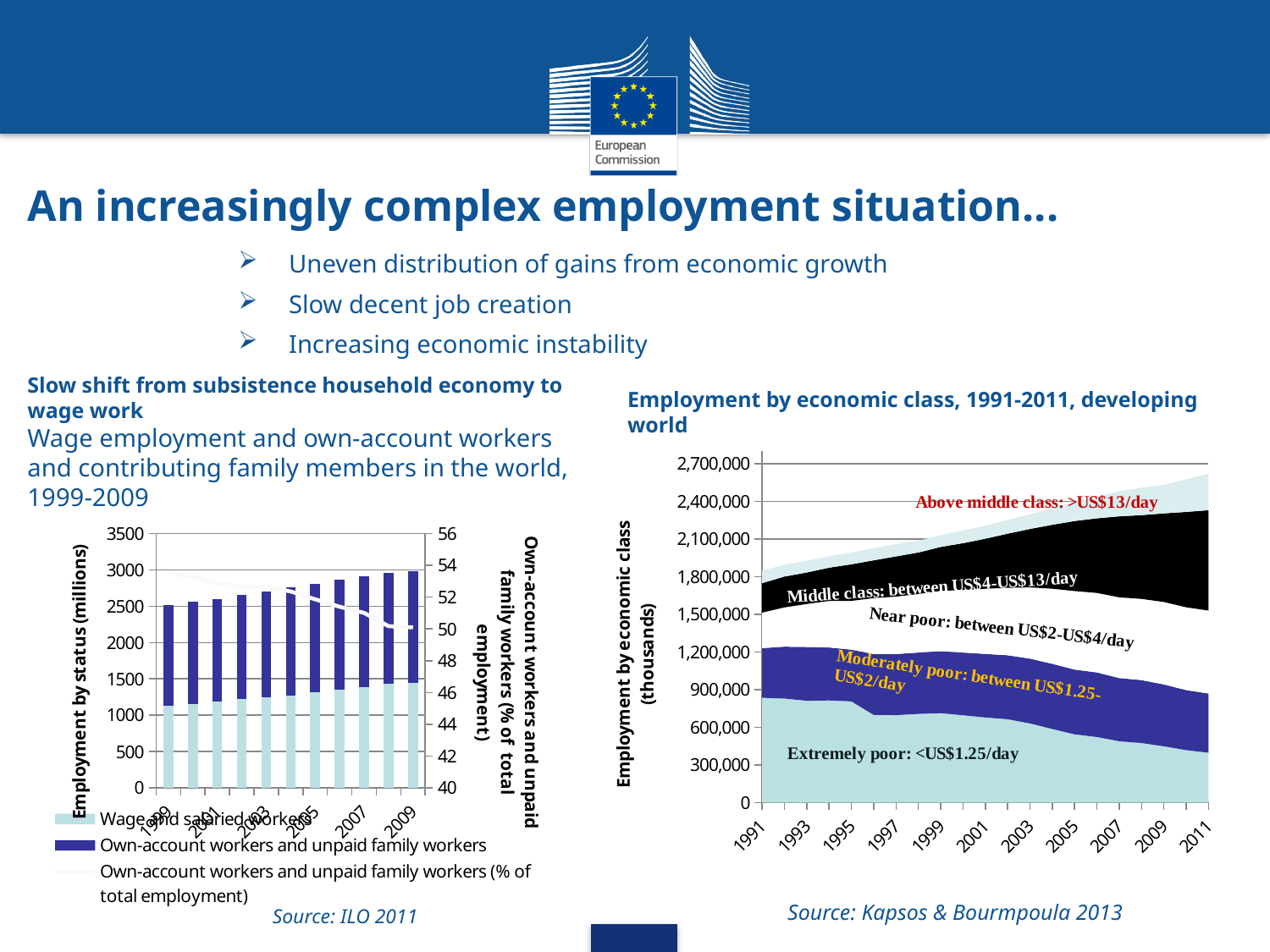
What kind of chart is the right chart, 'Employment by economic class, 1991-2011, developing world'? A stacked area chart In the right chart (Employment by economic class), how many economic classes are shown? 5 In the left chart (1999-2009), how many entries does the legend list? 3 What kind of chart is the left chart, 'Wage employment and own-account workers and contributing family members in the world, 1999-2009'? A stacked bar chart with a line In the left chart (1999-2009), is the value for wage and salaried workers in 2009 greater or less than 1000 million? greater In the left chart (1999-2009), does the line for own-account workers and unpaid family workers (% of total employment) rise or fall from 1999 to 2009? It falls In the left chart (1999-2009), how many years (bars) are plotted? 11 In the right chart (Employment by economic class), which economic class is shown at the bottom of the stacked areas? Extremely poor: <US$1.25/day In the left chart (1999-2009), do the wage and salaried workers bars rise or fall from 1999 to 2009? They rise In the right chart (Employment by economic class), is the value for the extremely poor in 2011 greater or less than 600,000 thousand? less In the left chart (1999-2009), is the share of own-account workers and unpaid family workers in total employment in 2009 greater or less than 52%? less